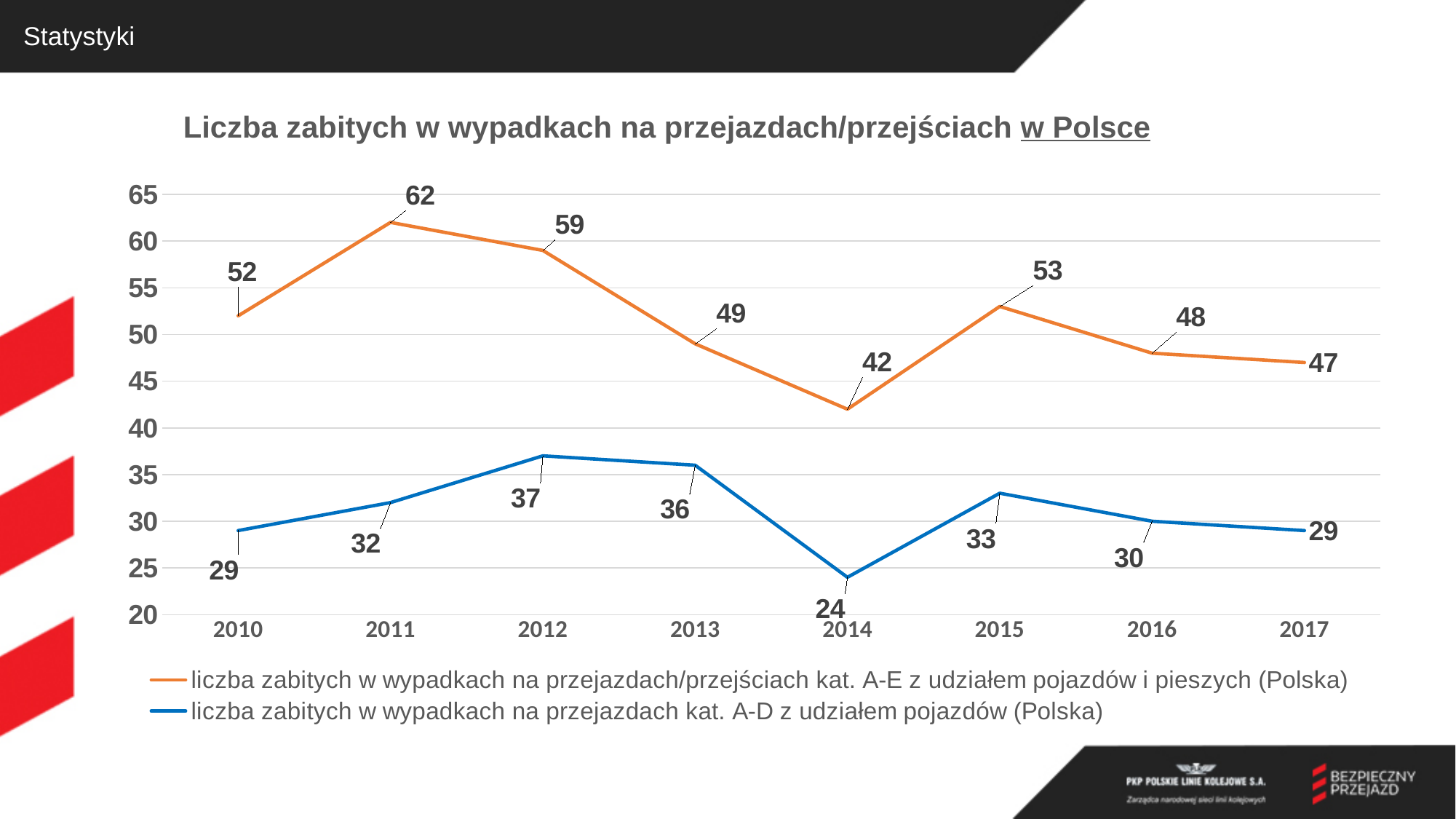
In which year is the orange series (kat. A-E) highest? 2011 What kind of chart is shown on the slide? line chart How many years are shown on the x axis? 8 How many series does the legend list? 2 What is the value of the orange series (kat. A-E z udziałem pojazdów i pieszych) in 2011? 62 Which is larger: the blue series value in 2012 or in 2015? 2012 What is the value of the orange series (kat. A-E) in 2017? 47 Does the orange series rise or fall from 2011 to 2014? fall What is the difference between the orange series and the blue series in 2014? 18 What is the title of the chart? Liczba zabitych w wypadkach na przejazdach/przejściach w Polsce In which year is the blue series (kat. A-D) lowest? 2014 What is the value of the blue series (kat. A-D z udziałem pojazdów) in 2014? 24